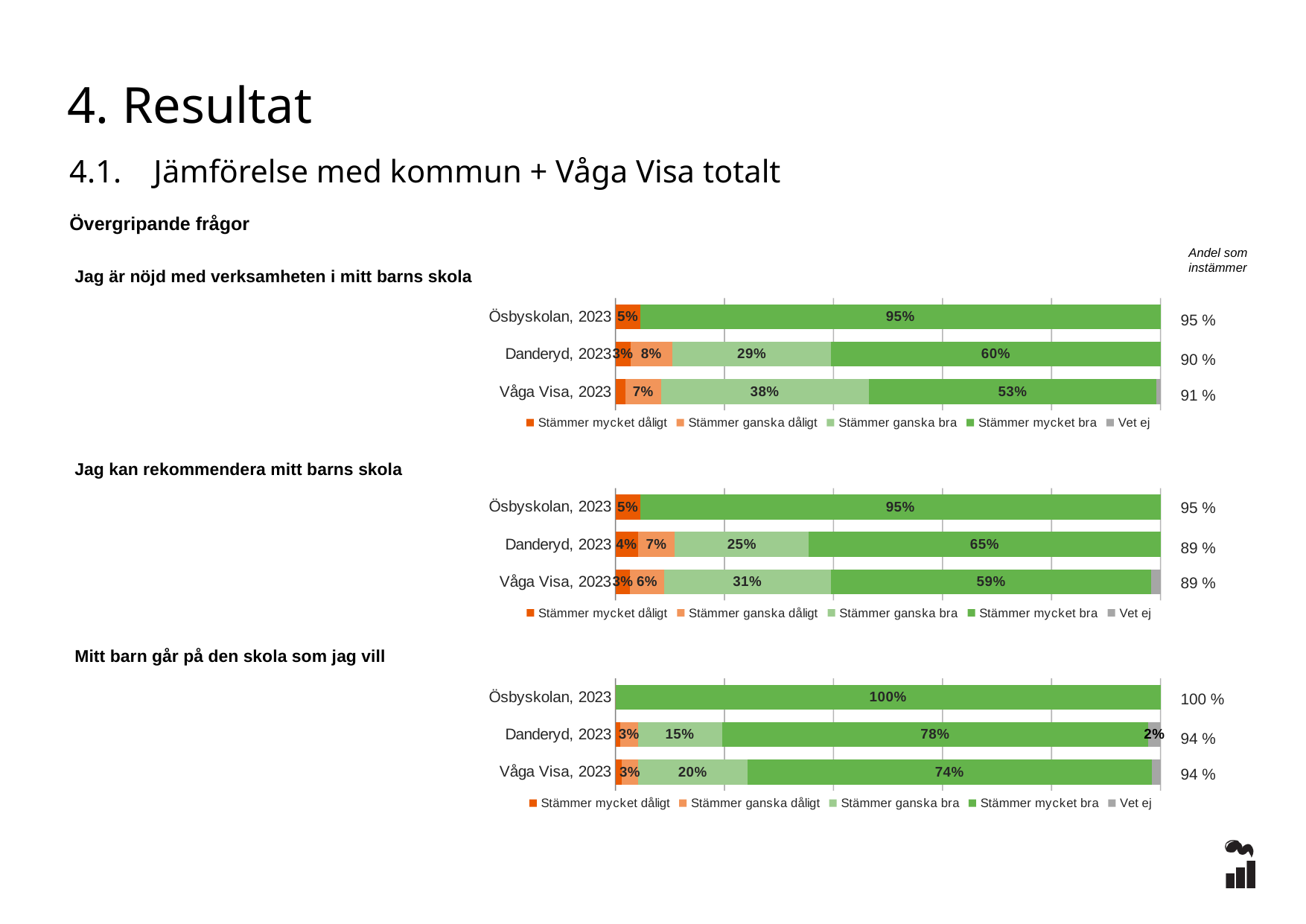
How many rows (categories) are shown in the chart 'Mitt barn går på den skola som jag vill'? 3 In the chart 'Jag är nöjd med verksamheten i mitt barns skola', which row has the highest 'Stämmer mycket bra' value? Ösbyskolan, 2023 In the chart 'Mitt barn går på den skola som jag vill', what is the 'Vet ej' value for Danderyd, 2023? 2% How many series does the legend of the chart 'Jag kan rekommendera mitt barns skola' list? 5 In the chart 'Jag kan rekommendera mitt barns skola', which is larger: the 'Stämmer ganska dåligt' value for Danderyd, 2023 or for Våga Visa, 2023? Danderyd, 2023 What kind of chart is 'Jag är nöjd med verksamheten i mitt barns skola'? Stacked bar chart In the chart 'Mitt barn går på den skola som jag vill', what is the 'Stämmer mycket bra' value for Ösbyskolan, 2023? 100% In the chart 'Jag är nöjd med verksamheten i mitt barns skola', what is the 'Stämmer mycket bra' value for Danderyd, 2023? 60% In the chart 'Mitt barn går på den skola som jag vill', what is the 'Stämmer ganska bra' value for Våga Visa, 2023? 20% In the chart 'Jag kan rekommendera mitt barns skola', what is the difference between the 'Stämmer mycket bra' values for Danderyd, 2023 and Våga Visa, 2023? 6% In the chart 'Jag är nöjd med verksamheten i mitt barns skola', what is the 'Stämmer ganska bra' value for Våga Visa, 2023? 38% In the chart 'Jag kan rekommendera mitt barns skola', what is the 'Stämmer ganska bra' value for Danderyd, 2023? 25%